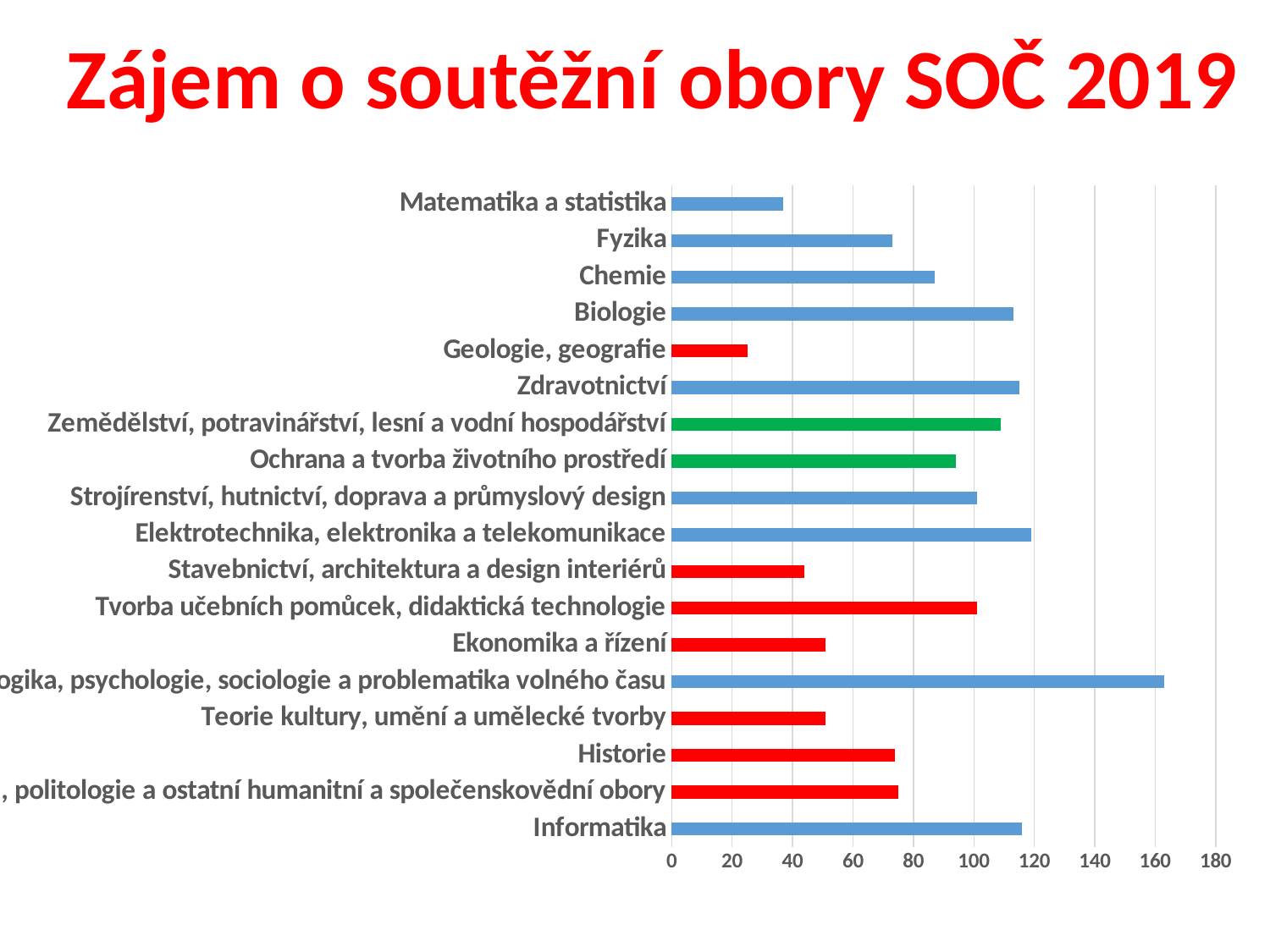
Is the value for Informatika greater or less than 100? greater How many categories are plotted in the chart? 18 Which has a larger value, Historie or Informatika? Informatika Which category has the lowest value in the chart? Geologie, geografie Is the value for Fyzika greater or less than 80? less Is the value for Chemie greater or less than 80? greater What kind of chart is shown on the slide? bar chart What is the title of the slide containing the chart? Zájem o soutěžní obory SOČ 2019 Which has a larger value, Biologie or Chemie? Biologie